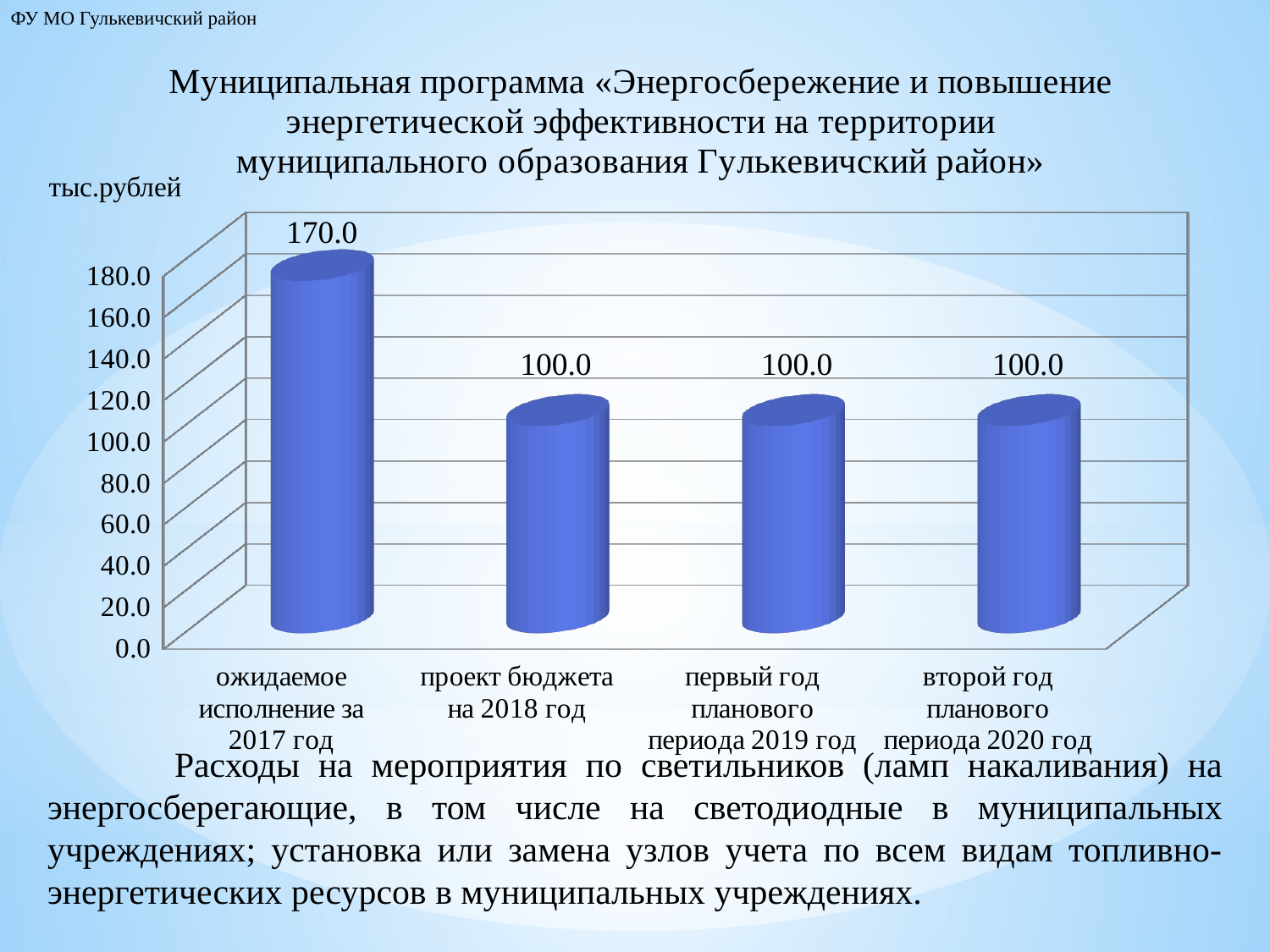
How many categories are shown on the chart? 4 What is the value for 'проект бюджета на 2018 год'? 100.0 What unit is indicated above the vertical axis of the chart? тыс.рублей What kind of chart is shown on the slide? bar chart Is the value for 'ожидаемое исполнение за 2017 год' greater or less than 140.0? greater What is the value for 'ожидаемое исполнение за 2017 год'? 170.0 What is the value for 'второй год планового периода 2020 год'? 100.0 Which category has the highest value? ожидаемое исполнение за 2017 год Which is larger: the value for 'ожидаемое исполнение за 2017 год' or the value for 'первый год планового периода 2019 год'? ожидаемое исполнение за 2017 год Do the values rise or fall from the 2017 category to the 2018 category? fall What is the difference between the value for 2017 and the value for 2018? 70.0 What is the highest tick value shown on the vertical axis? 180.0